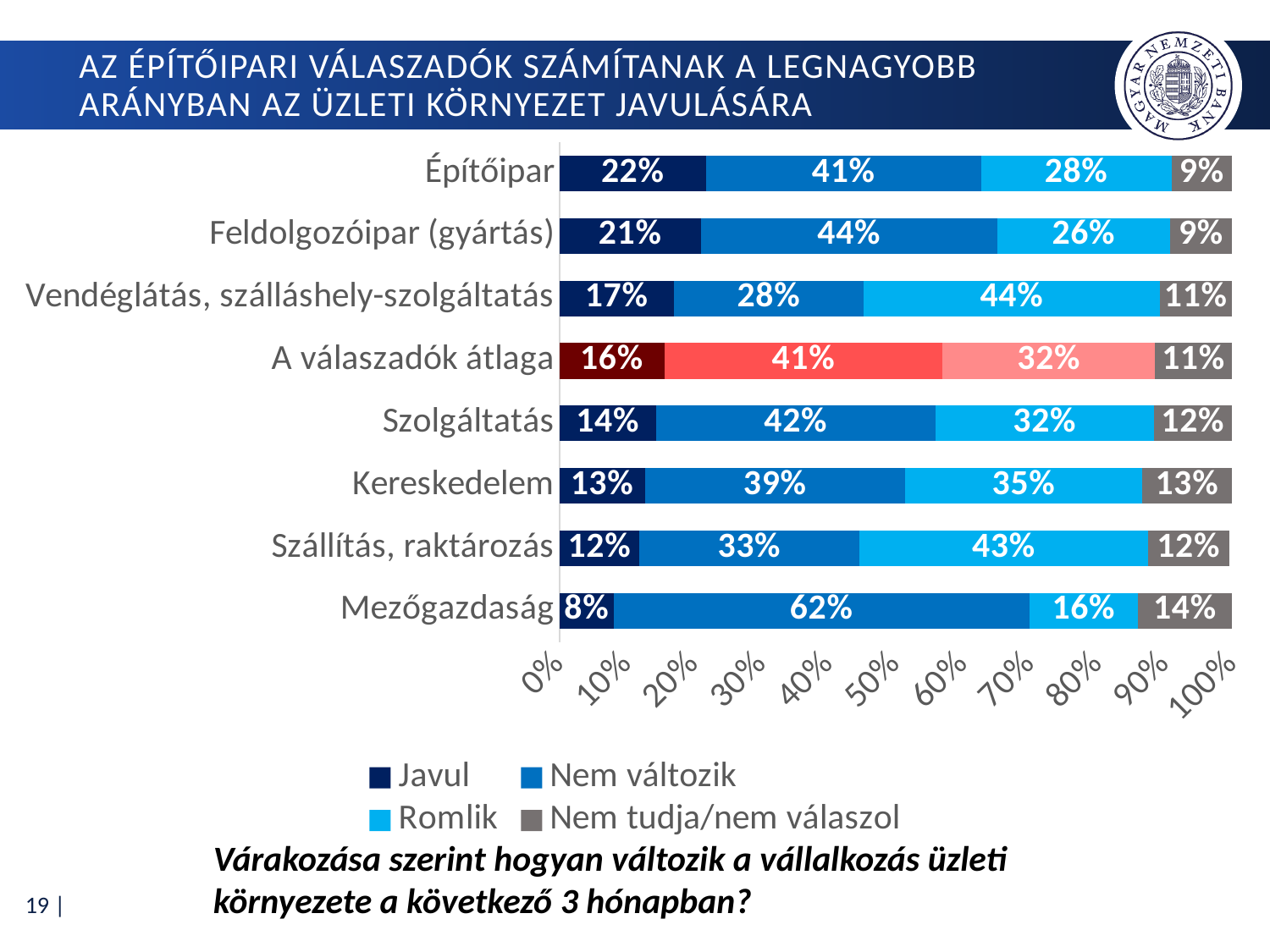
How many series does the legend list? 4 Which category has the highest 'Nem változik' value? Mezőgazdaság What is the 'Romlik' value for Szállítás, raktározás? 43% Which is larger: the 'Nem változik' value for Feldolgozóipar (gyártás) or for Szolgáltatás? Feldolgozóipar (gyártás) Which category has the lowest 'Javul' value? Mezőgazdaság What is the 'Javul' value for Építőipar? 22% What is the difference between the 'Romlik' values for Vendéglátás, szálláshely-szolgáltatás and Építőipar? 16% How many categories are shown on the chart? 8 What is the 'Nem változik' value for Mezőgazdaság? 62% What is the 'Nem tudja/nem válaszol' value for Kereskedelem? 13% Which category has the highest 'Javul' value? Építőipar What kind of chart is shown on the slide? Stacked bar chart